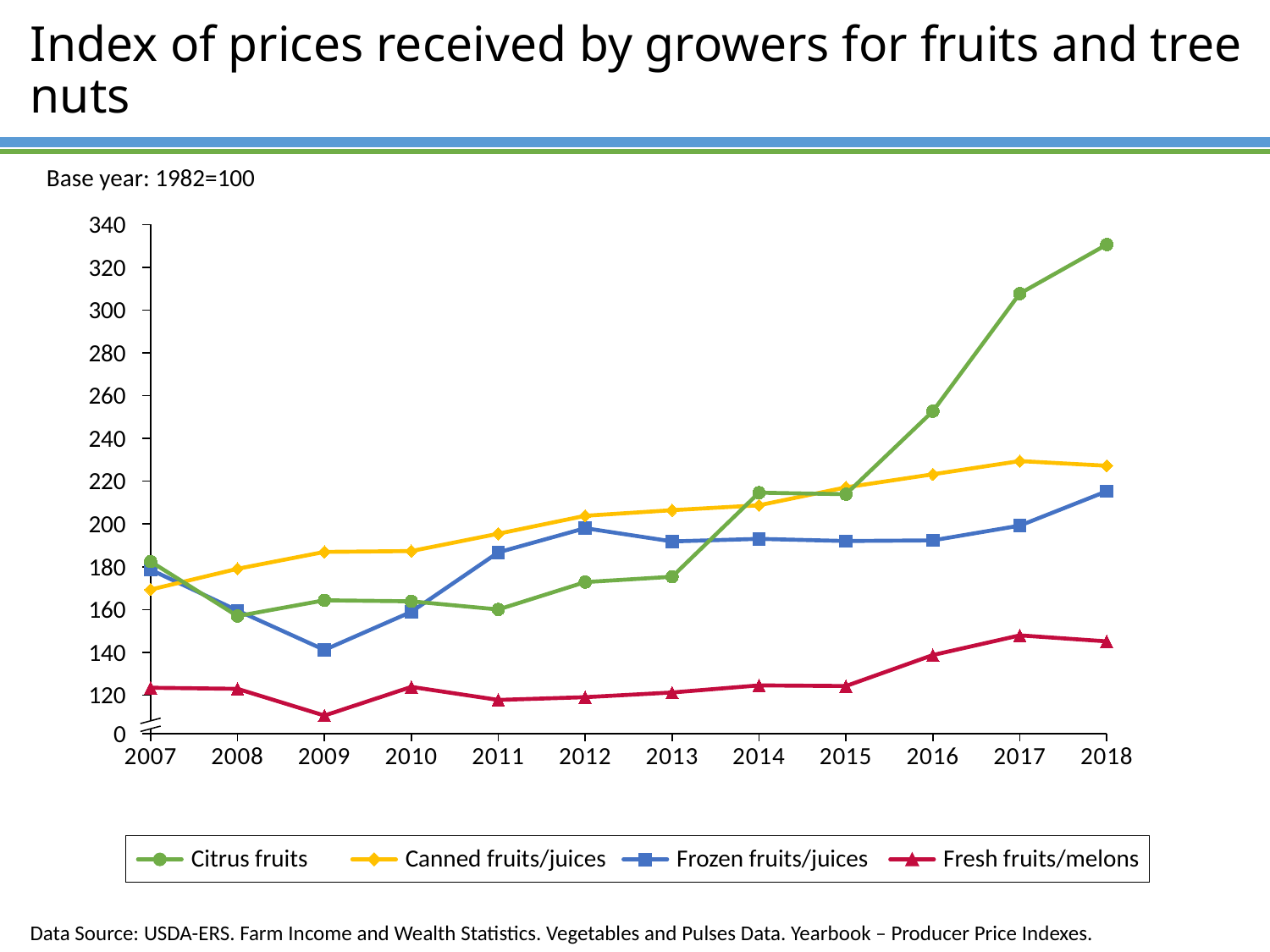
In 2010, which is higher: Canned fruits/juices or Frozen fruits/juices? Canned fruits/juices What kind of chart is shown on the slide? line chart Is the value for Fresh fruits/melons in 2009 greater or less than 120? less How many series does the legend list? 4 What base year is stated for the index on the slide? 1982=100 Which series has the highest value in 2018? Citrus fruits Which series has the lowest value in 2018? Fresh fruits/melons Is the value for Citrus fruits in 2018 greater or less than 300? greater Do the values for Citrus fruits rise or fall from 2015 to 2018? rise Is the value for Frozen fruits/juices in 2018 greater or less than 200? greater How many years are plotted along the x axis? 12 In which year is the value for Frozen fruits/juices lowest? 2009